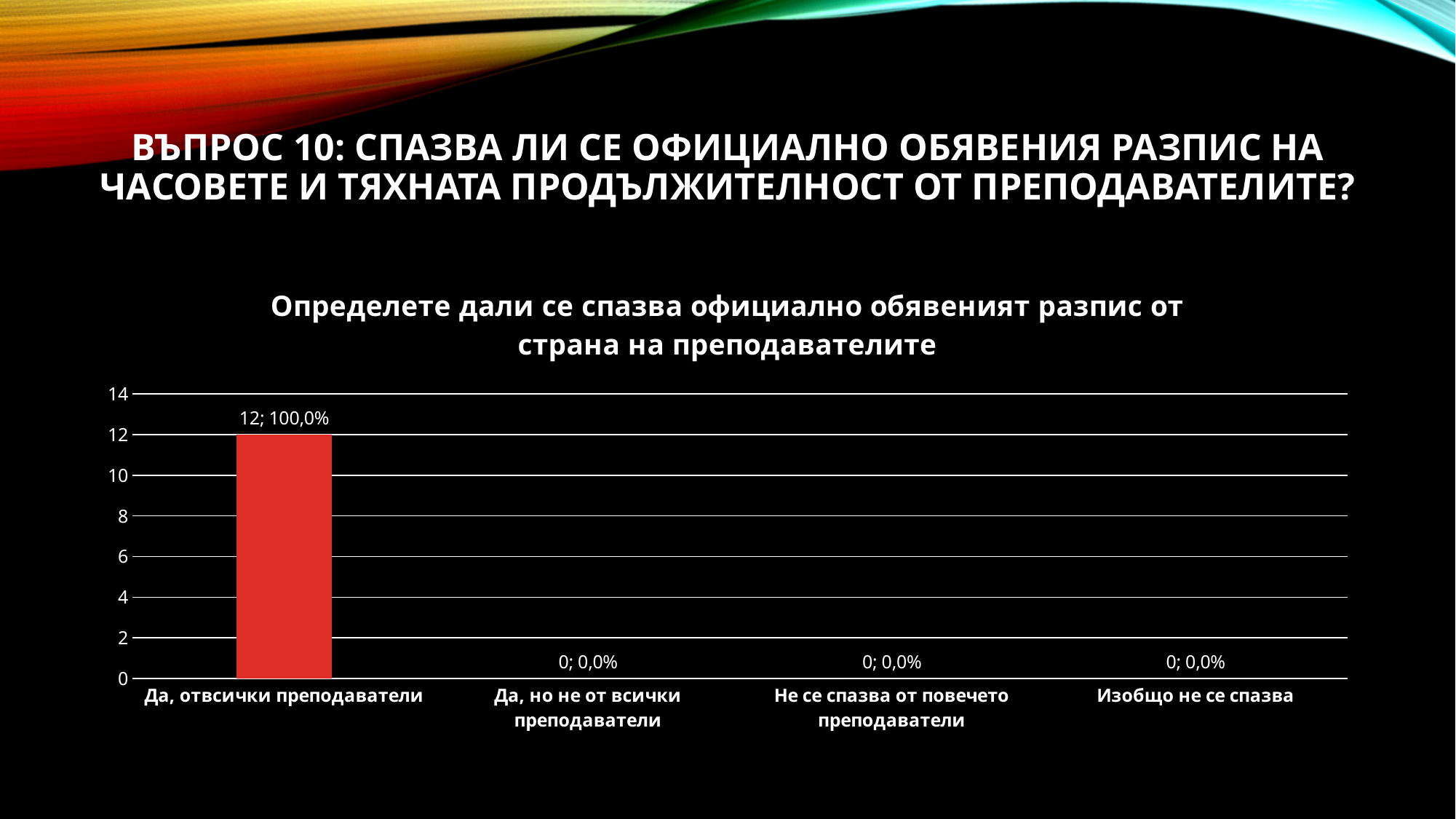
What type of chart is shown on the slide? bar chart Which is larger, the value for "Да, отвсички преподаватели" or the value for "Да, но не от всички преподаватели"? Да, отвсички преподаватели What percentage share is shown for "Да, отвсички преподаватели"? 100,0% How many categories are shown on the x axis? 4 What colour is the bar for "Да, отвсички преподаватели"? red What is the value for "Да, но не от всички преподаватели"? 0; 0,0% What is the value for "Изобщо не се спазва"? 0; 0,0% Is the value for "Да, отвсички преподаватели" greater or less than 10? greater What is the difference between the values for "Да, отвсички преподаватели" and "Не се спазва от повечето преподаватели"? 12 What is the title of the chart? Определете дали се спазва официално обявеният разпис от страна на преподавателите Which category has the highest value? Да, отвсички преподаватели What is the value for "Да, отвсички преподаватели"? 12; 100,0%